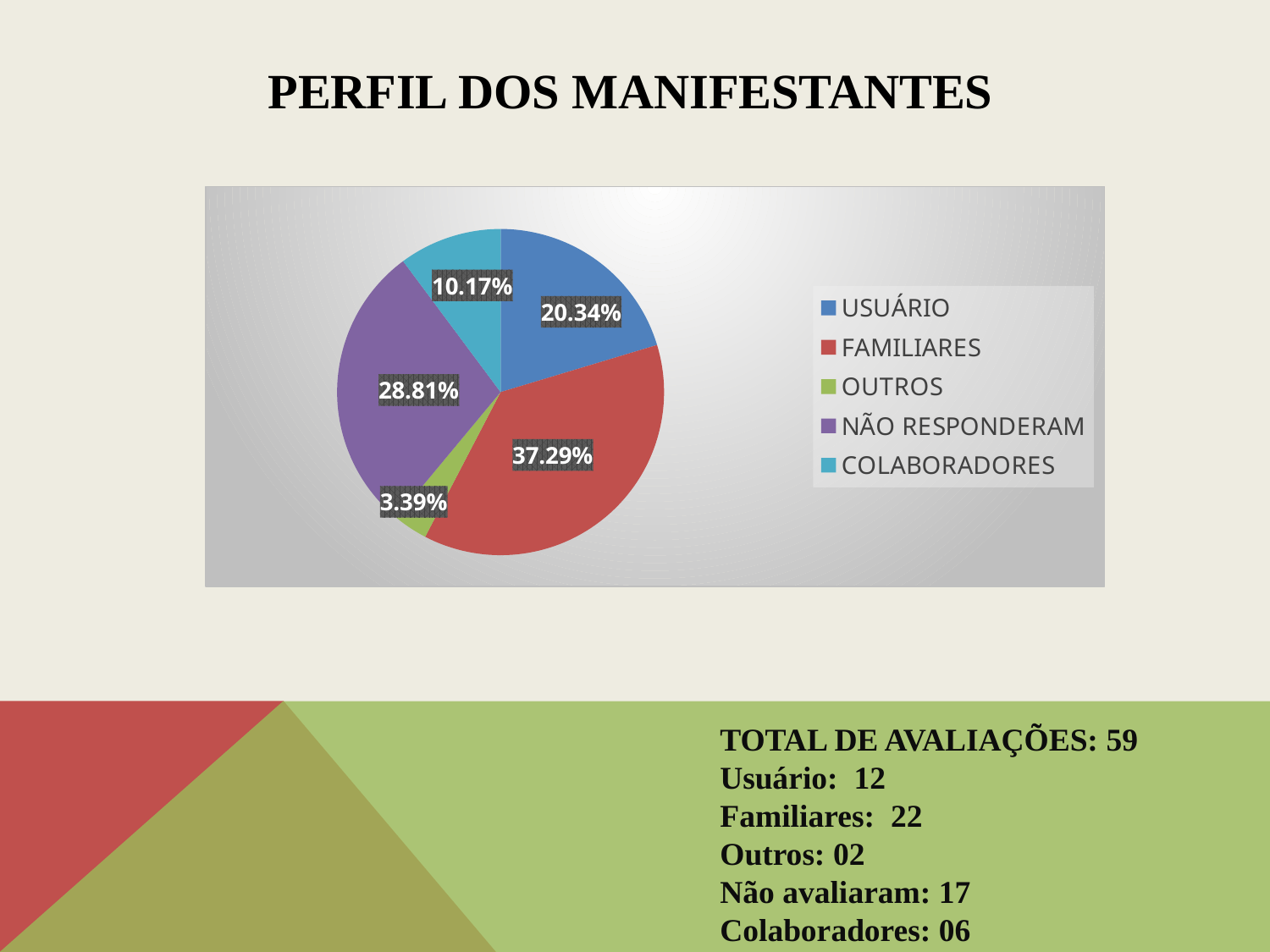
What kind of chart is shown on the slide? pie chart Which category has the smallest slice of the pie? OUTROS What colour is the slice for NÃO RESPONDERAM? purple How many categories does the legend of the pie chart list? 5 What percentage of the pie does FAMILIARES represent? 37.29% What percentage of the pie does USUÁRIO represent? 20.34% What percentage of the pie does OUTROS represent? 3.39% What percentage of the pie does COLABORADORES represent? 10.17% What percentage of the pie does NÃO RESPONDERAM represent? 28.81% Which is larger, the slice for USUÁRIO or the slice for NÃO RESPONDERAM? NÃO RESPONDERAM What is the difference in percentage points between the FAMILIARES slice and the USUÁRIO slice? 16.95 Which category has the largest slice of the pie? FAMILIARES